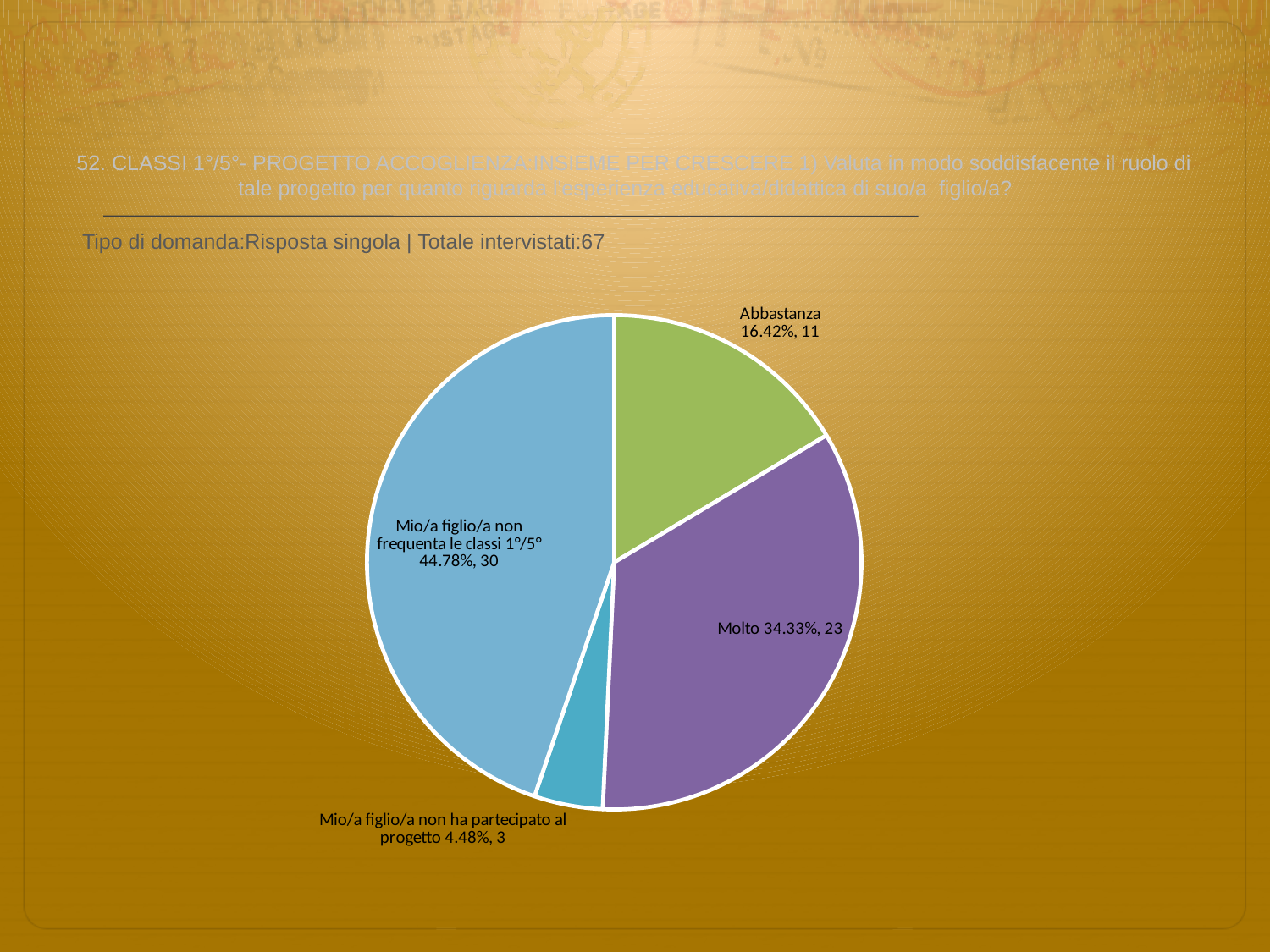
What percentage of the pie is the "Molto" slice? 34.33% How many respondents answered "Mio/a figlio/a non frequenta le classi 1°/5°"? 30 What is the total number of respondents (Totale intervistati) stated on the slide? 67 Which category has the smallest slice of the pie? Mio/a figlio/a non ha partecipato al progetto How many respondents answered "Abbastanza"? 11 What percentage of the pie is the "Abbastanza" slice? 16.42% What colour is the "Molto" slice of the pie? purple What is the difference in respondent count between "Molto" and "Abbastanza"? 12 How many slices does the pie chart have? 4 Which category has the largest slice of the pie? Mio/a figlio/a non frequenta le classi 1°/5° Which has more respondents, "Molto" or "Abbastanza"? Molto What kind of chart is shown on the slide? pie chart